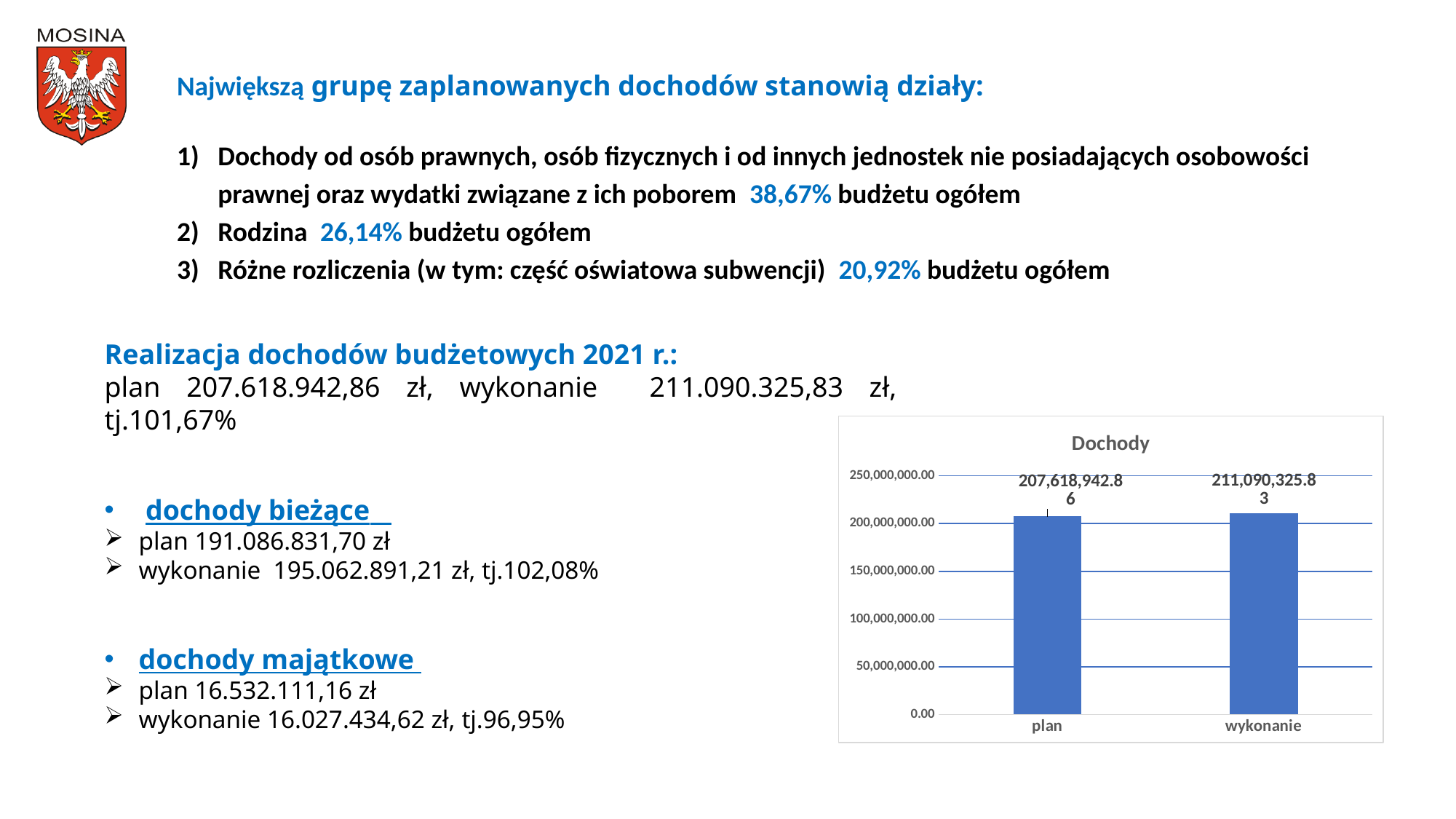
What is the value of the plan bar in the Dochody chart? 207,618,942.86 How many bars are shown in the Dochody chart? 2 Is the value for plan in the Dochody chart greater or less than 200,000,000.00? greater What type of chart is the Dochody chart? bar chart What is the value of the wykonanie bar in the Dochody chart? 211,090,325.83 What is the highest value shown on the y axis of the Dochody chart? 250,000,000.00 Is the value for wykonanie in the Dochody chart greater or less than 250,000,000.00? less Which bar in the Dochody chart has the higher value, plan or wykonanie? wykonanie What is the difference between the wykonanie and plan values in the Dochody chart? 3,471,382.97 What is the title of the chart on the slide? Dochody Which category in the Dochody chart has the lowest value? plan Which category in the Dochody chart has the highest value? wykonanie